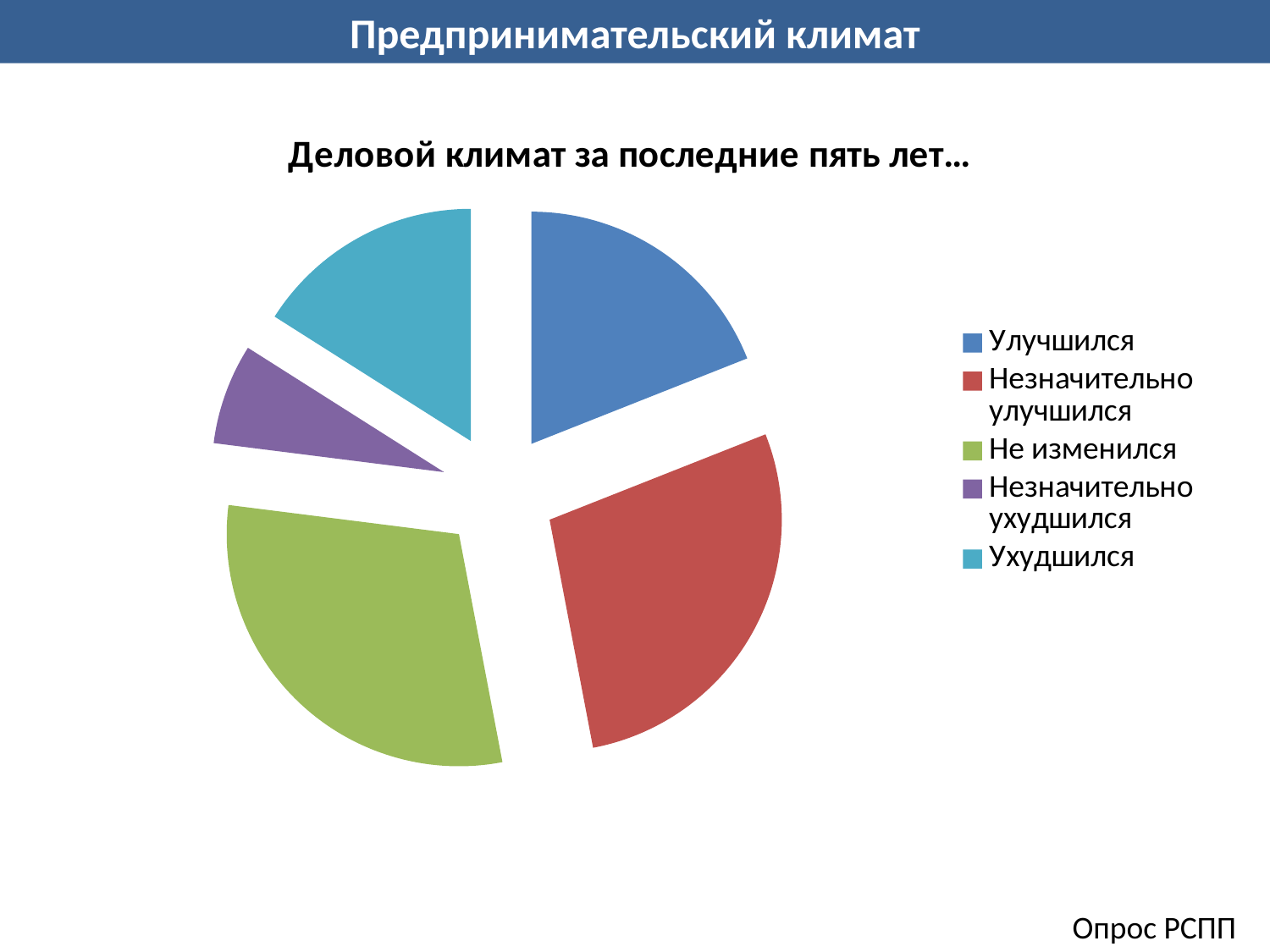
Which slice is larger, "Незначительно улучшился" or "Незначительно ухудшился"? Незначительно улучшился How many slices does the pie chart have? 5 Which slice is larger, "Незначительно улучшился" or "Улучшился"? Незначительно улучшился How many entries does the legend of the pie chart list? 5 What kind of chart is shown on the slide? pie chart Which slice is larger, "Улучшился" or "Незначительно ухудшился"? Улучшился What is the title of the pie chart? Деловой климат за последние пять лет… What colour is the "Не изменился" slice in the pie chart? green Which category has the smallest slice in the pie chart? Незначительно ухудшился